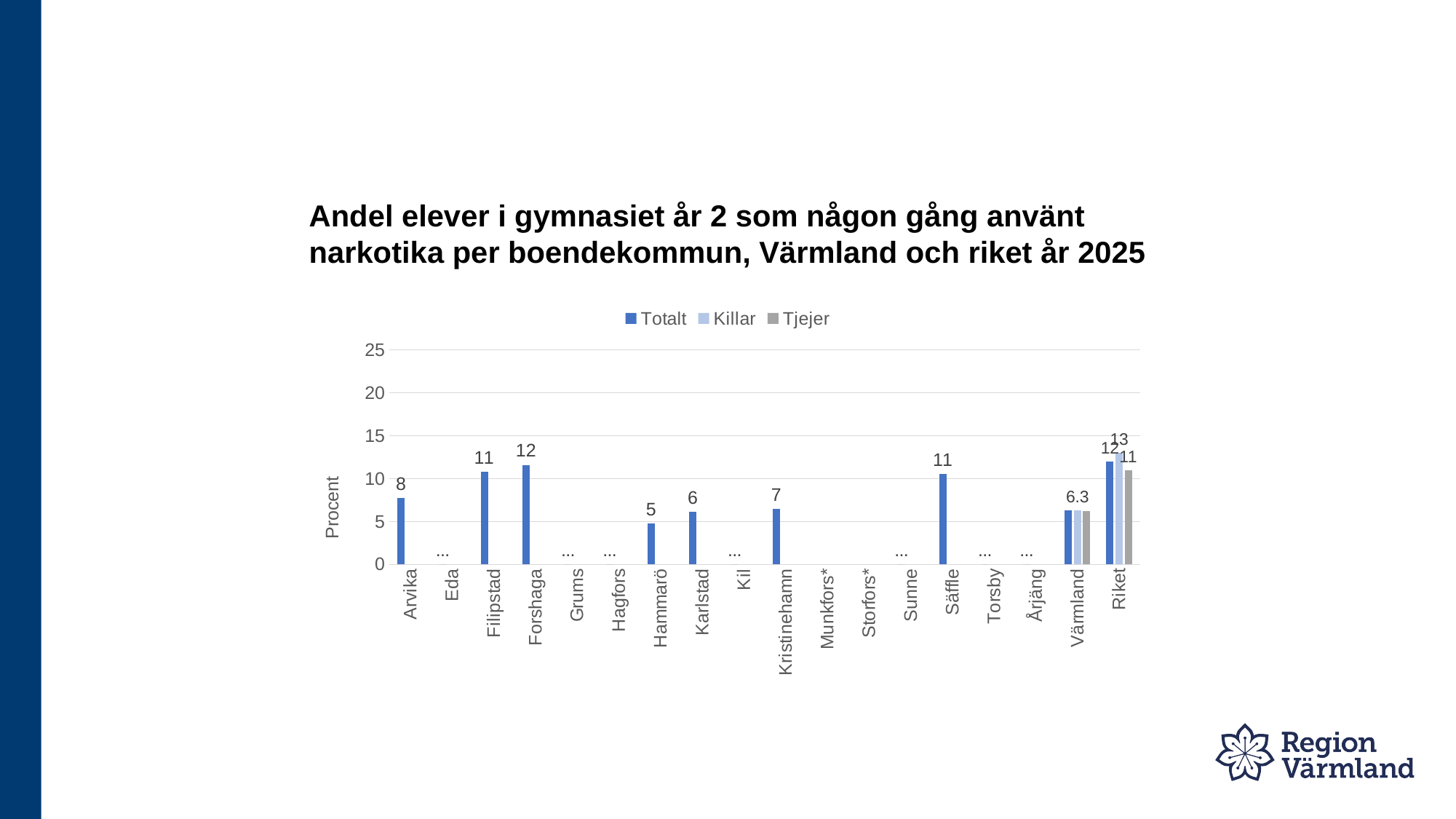
What is the Totalt value for Arvika? 8 How many series does the legend list? 3 What kind of chart is shown on the slide? bar chart Which has the higher Totalt value, Filipstad or Karlstad? Filipstad Is the Totalt value for Kristinehamn greater or less than 10? less What is the Killar value for Riket? 13 What is the Totalt value for Forshaga? 12 Among the municipalities with a labelled Totalt value, which has the lowest value? Hammarö What is the Tjejer value for Riket? 11 What is the difference between the Totalt values for Forshaga and Hammarö? 7 What is the label on the vertical axis? Procent